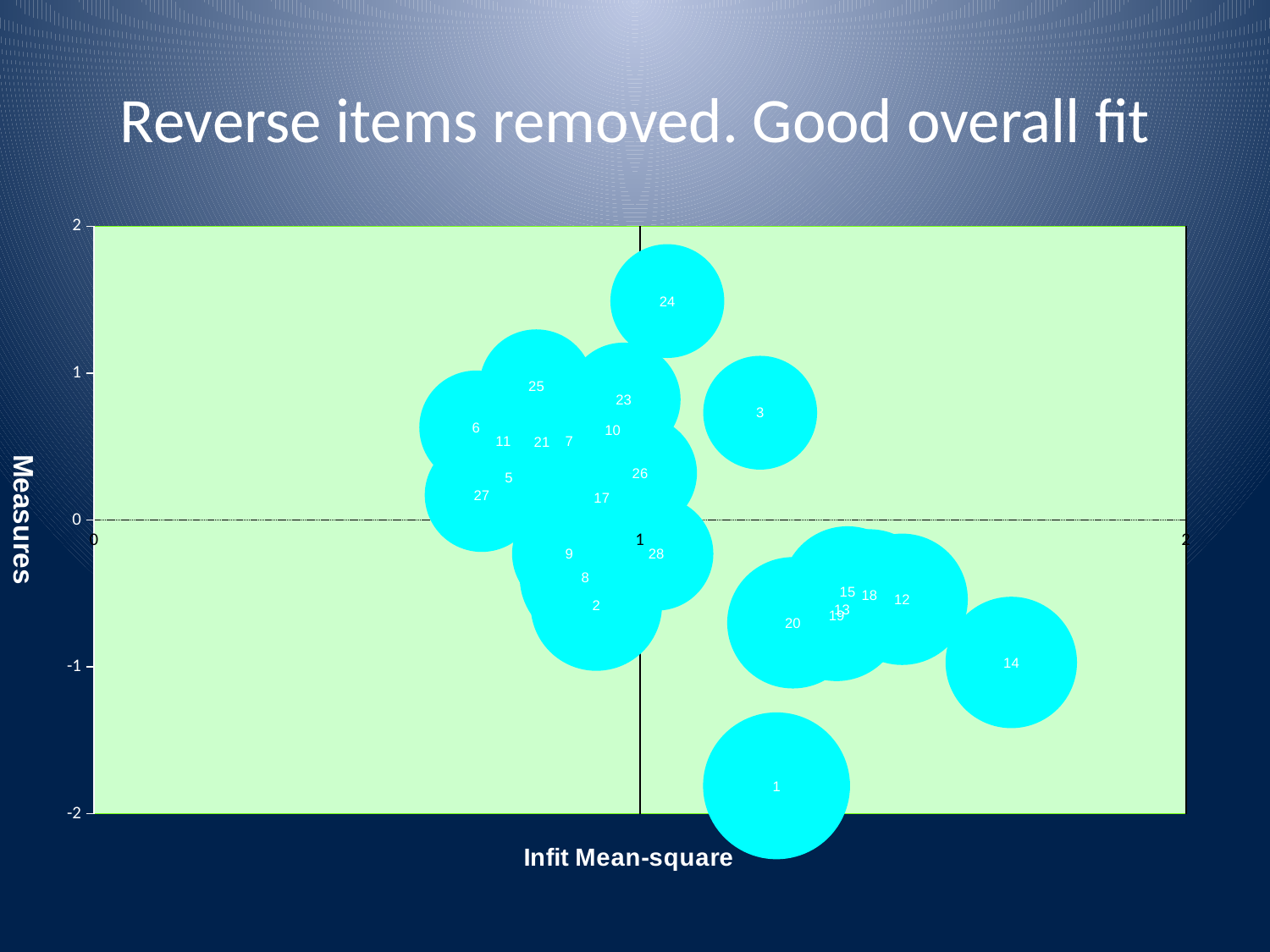
Which item has the highest Infit Mean-square value? 14 What kind of chart is shown on the slide? Bubble chart Which item has the higher Measures value, item 24 or item 3? 24 Is the Measures value for item 24 greater or less than 1? greater Is the Measures value for item 1 greater or less than -1? less Which item has the larger Infit Mean-square value, item 14 or item 6? 14 Which item has the lowest Measures value? 1 Is the Infit Mean-square value for item 6 greater or less than 1? less What is the title of the horizontal axis? Infit Mean-square What is the title of the vertical axis? Measures Which item has the highest Measures value? 24